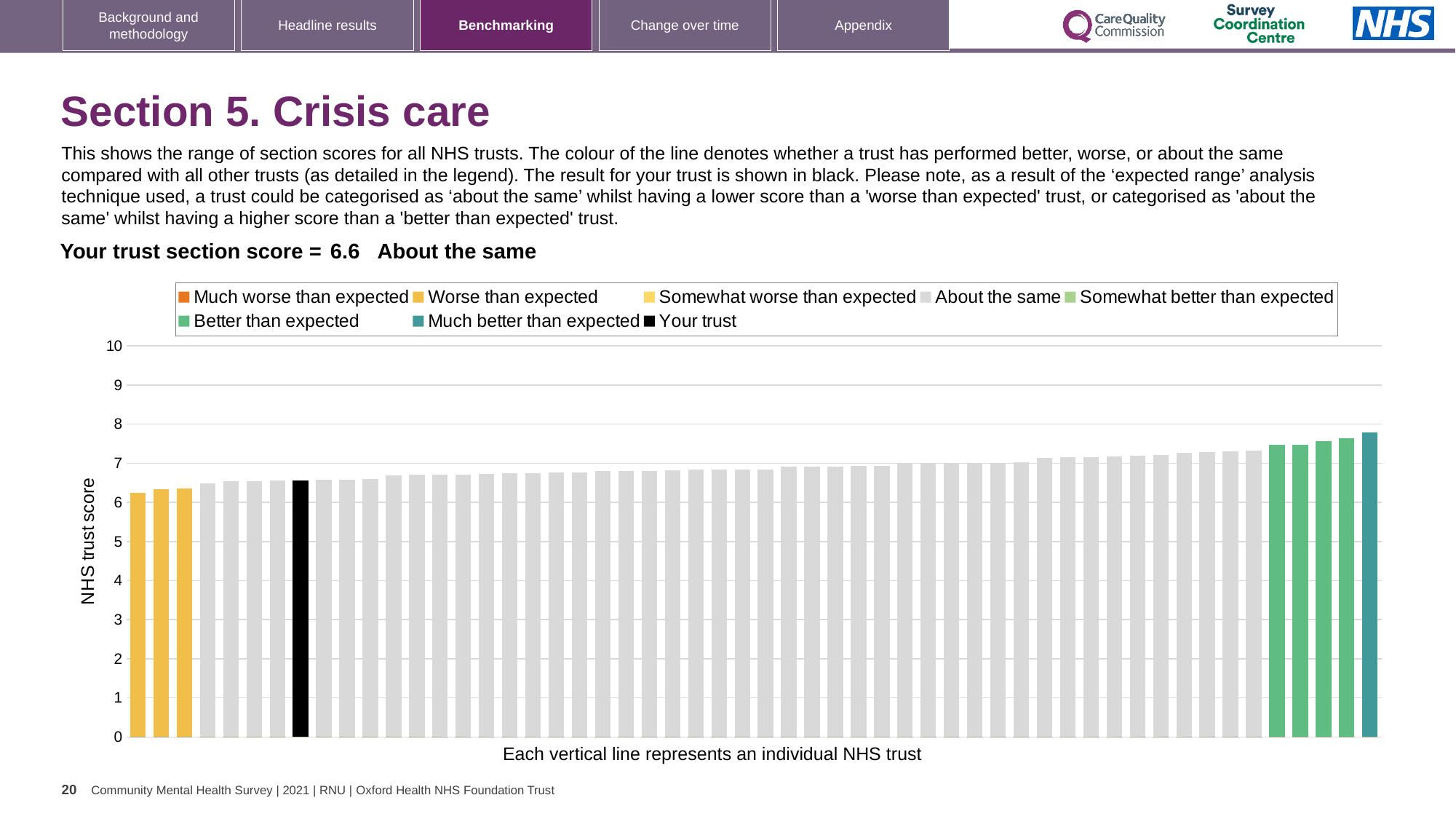
How many entries does the chart legend list? 8 How many bars are coloured as 'Worse than expected'? 3 Is the value of the black 'Your trust' bar greater or less than 5? greater What kind of chart is shown on the slide? bar chart Is the value of the tallest bar greater or less than 7? greater How many bars are coloured as 'Better than expected'? 4 Which legend category does the tallest bar belong to? Much better than expected Which legend category does the shortest bar belong to? Worse than expected Do the bar values rise or fall from left to right along the x axis? rise What is the label on the vertical axis of the chart? NHS trust score What is the section score for your trust shown on the slide? 6.6 Is the value of the shortest bar greater or less than 7? less